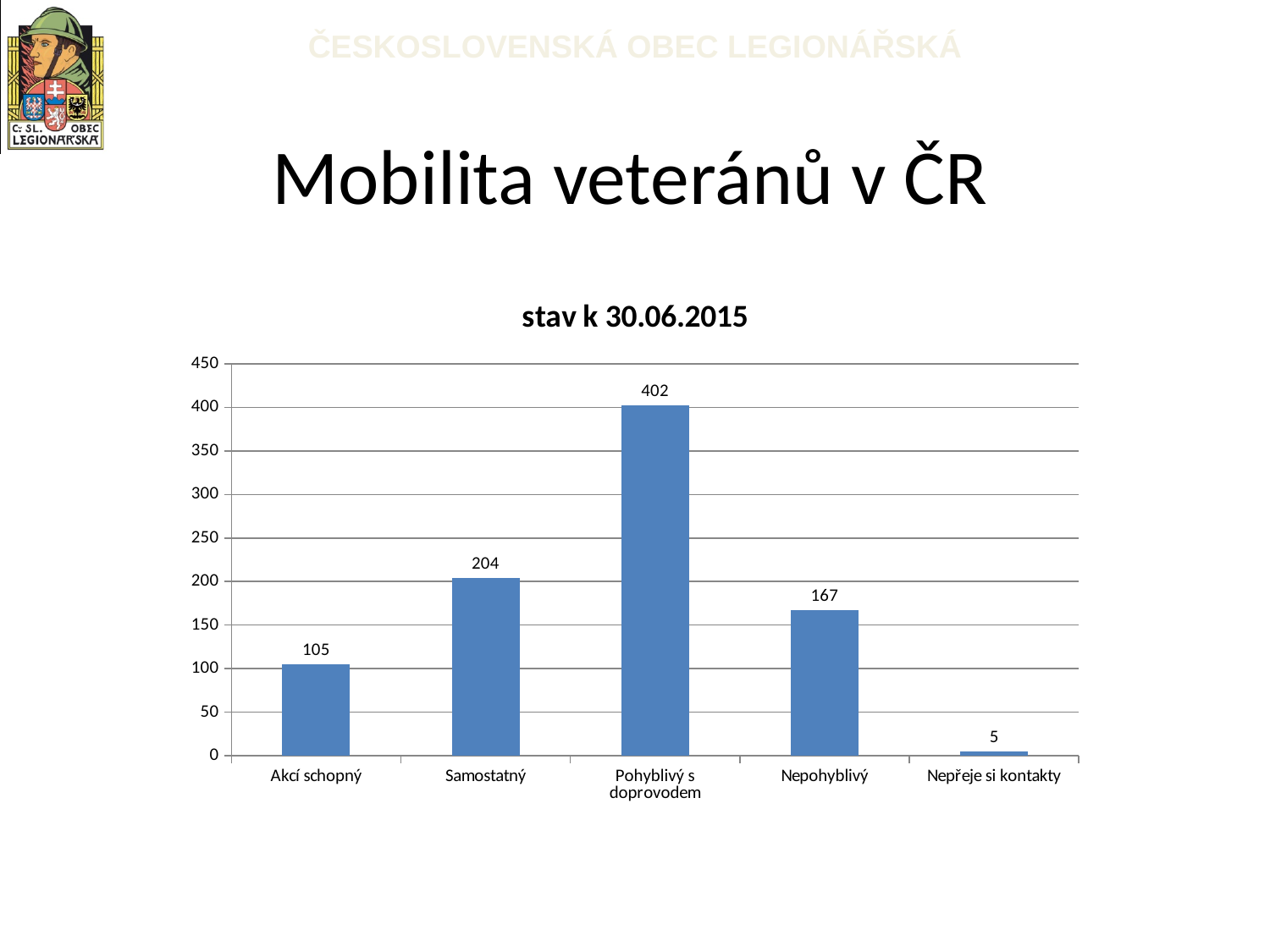
What is the value for Akcí schopný? 105 What is the title of the chart? stav k 30.06.2015 What is the value for Nepohyblivý? 167 What is the value for Samostatný? 204 What is the value for Nepřeje si kontakty? 5 Which category has the highest value? Pohyblivý s doprovodem What kind of chart is shown on the slide? bar chart Which is larger, the value for Samostatný or the value for Nepohyblivý? Samostatný What is the difference between the values for Pohyblivý s doprovodem and Samostatný? 198 How many categories are shown on the x axis? 5 Which category has the lowest value? Nepřeje si kontakty What is the value for Pohyblivý s doprovodem? 402